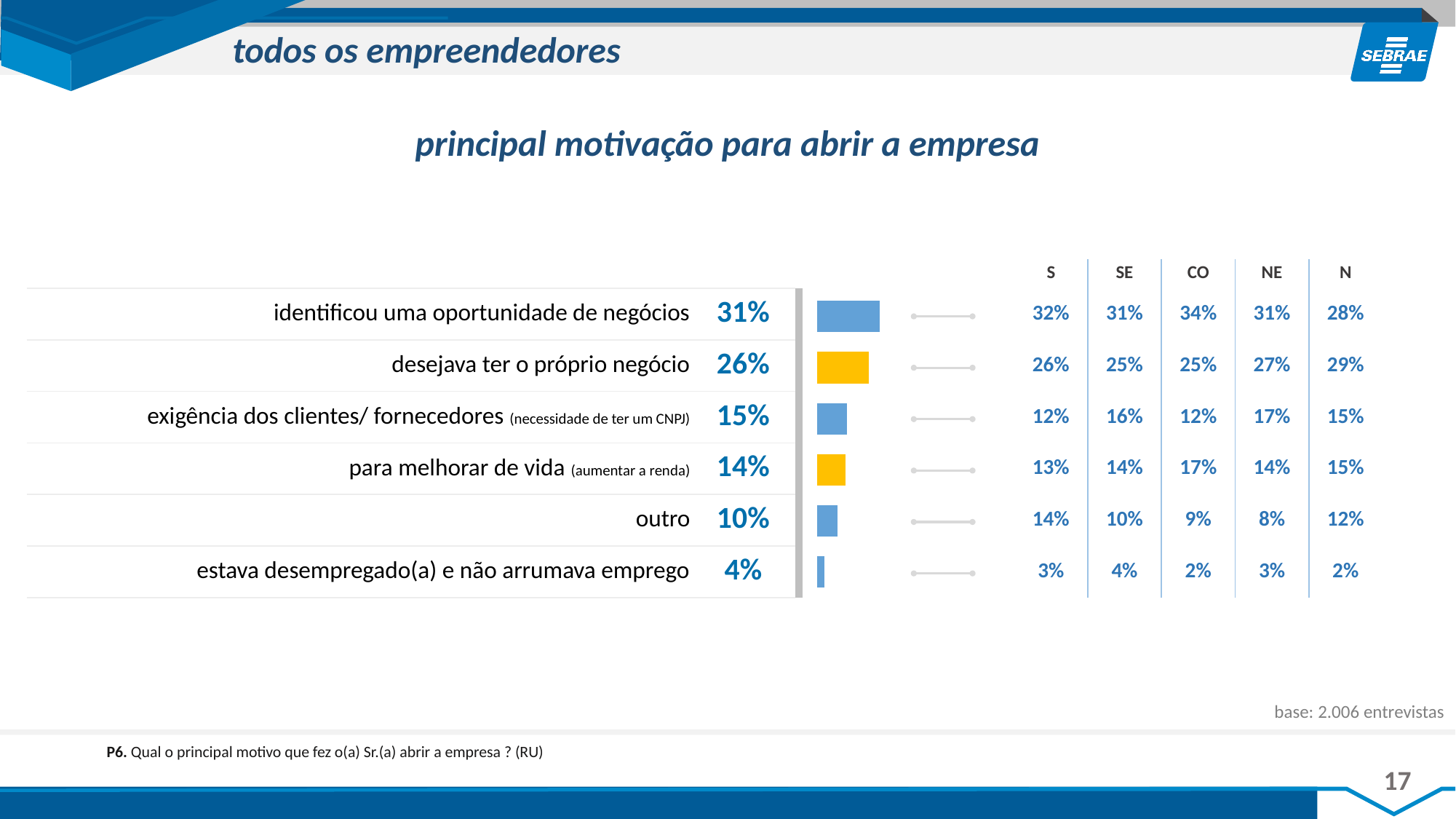
Which motivation has the lowest overall value? estava desempregado(a) e não arrumava emprego What is the overall value for 'desejava ter o próprio negócio'? 26% What is the value for 'outro' in region S? 14% What is the value for 'identificou uma oportunidade de negócios' in region CO? 34% What is the overall value for 'identificou uma oportunidade de negócios'? 31% What is the difference between the overall values for 'identificou uma oportunidade de negócios' and 'desejava ter o próprio negócio'? 5% Which motivation has the highest overall value? identificou uma oportunidade de negócios Which has a larger overall value: 'exigência dos clientes/ fornecedores' or 'para melhorar de vida'? exigência dos clientes/ fornecedores What is the overall value for 'estava desempregado(a) e não arrumava emprego'? 4% What kind of chart is used to show the overall values? bar chart How many motivation categories are shown in the chart? 6 What is the title of the chart? principal motivação para abrir a empresa